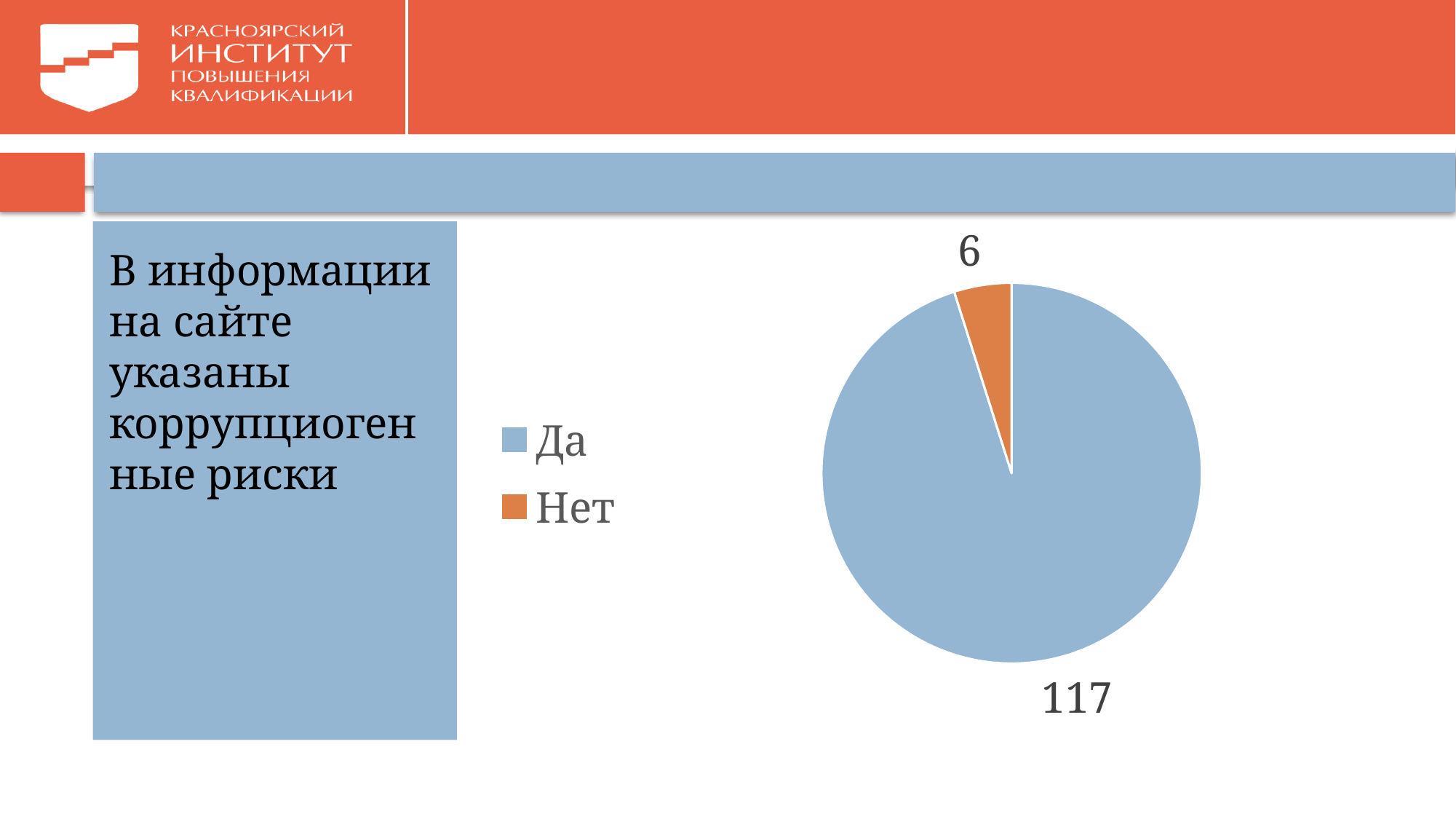
Which category has the smallest slice? Нет What is the total of all slices in the pie chart? 123 How many slices does the pie chart have? 2 What is the value for Нет? 6 What is the value for Да? 117 Which category has the largest slice? Да What colour is the slice for Да? blue What kind of chart is shown on the slide? pie chart What is the difference between the values for Да and Нет? 111 Which is larger, the value for Да or the value for Нет? Да How many entries does the legend list? 2 What colour is the slice for Нет? orange